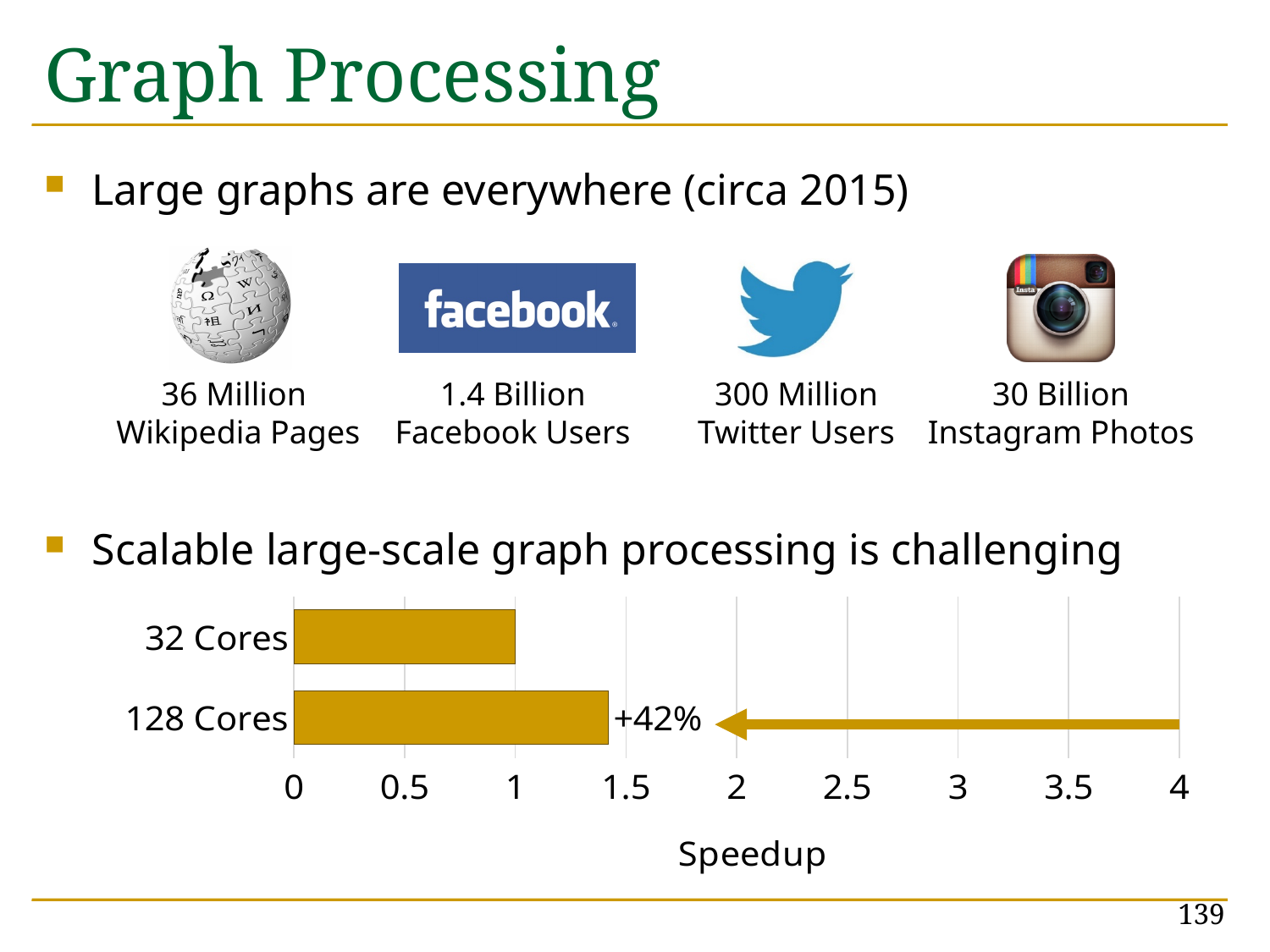
Which has the larger speedup, 32 Cores or 128 Cores? 128 Cores How many categories are plotted in the chart? 2 Is the speedup for 32 Cores greater or less than 2? less What annotation is printed next to the 128 Cores bar? +42% Which category has the highest speedup in the chart? 128 Cores Is the speedup for 128 Cores greater or less than 1? greater What is the speedup value for 32 Cores? 1 What is the label on the x axis of the chart? Speedup Is the speedup for 128 Cores greater or less than 1.5? less Which category has the lowest speedup in the chart? 32 Cores What kind of chart is shown on the slide? bar chart